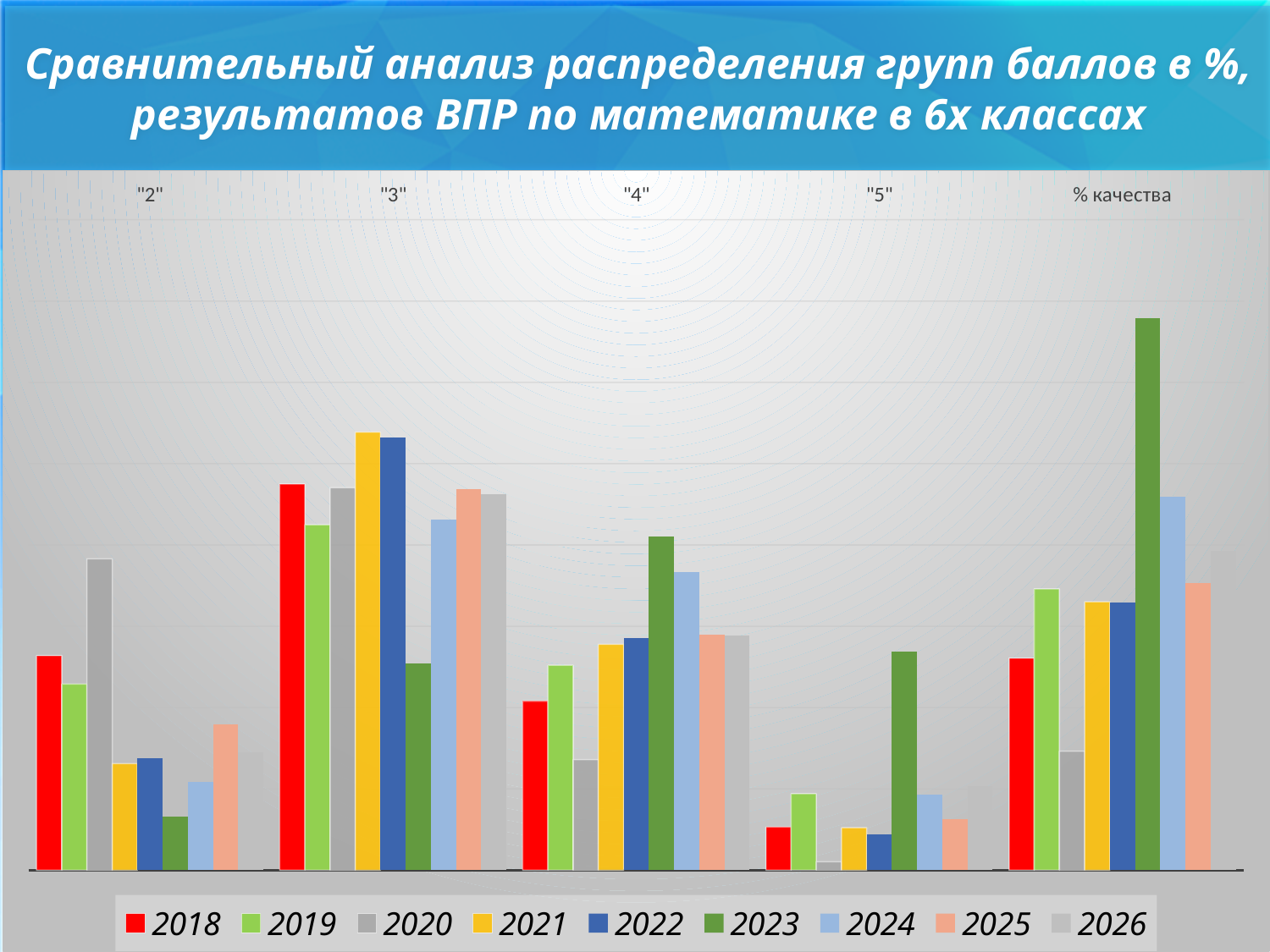
Which colour represents the 2018 series in the legend? red How many categories are shown along the x axis? 5 In the "5" category, which year has the lowest bar? 2020 In the "4" category, which year has the lowest bar? 2020 In the "% качества" category, which year has the highest bar? 2023 In the "5" category, which is larger: the value for 2018 or for 2019? 2019 In the "% качества" category, which is larger: the value for 2024 or for 2025? 2024 In the "2" category, which year has the highest bar? 2020 Across the categories, in which category is the 2018 bar the highest? "3" What kind of chart is shown on the slide? bar chart In the "3" category, which year has the lowest bar? 2023 How many series does the legend list? 9